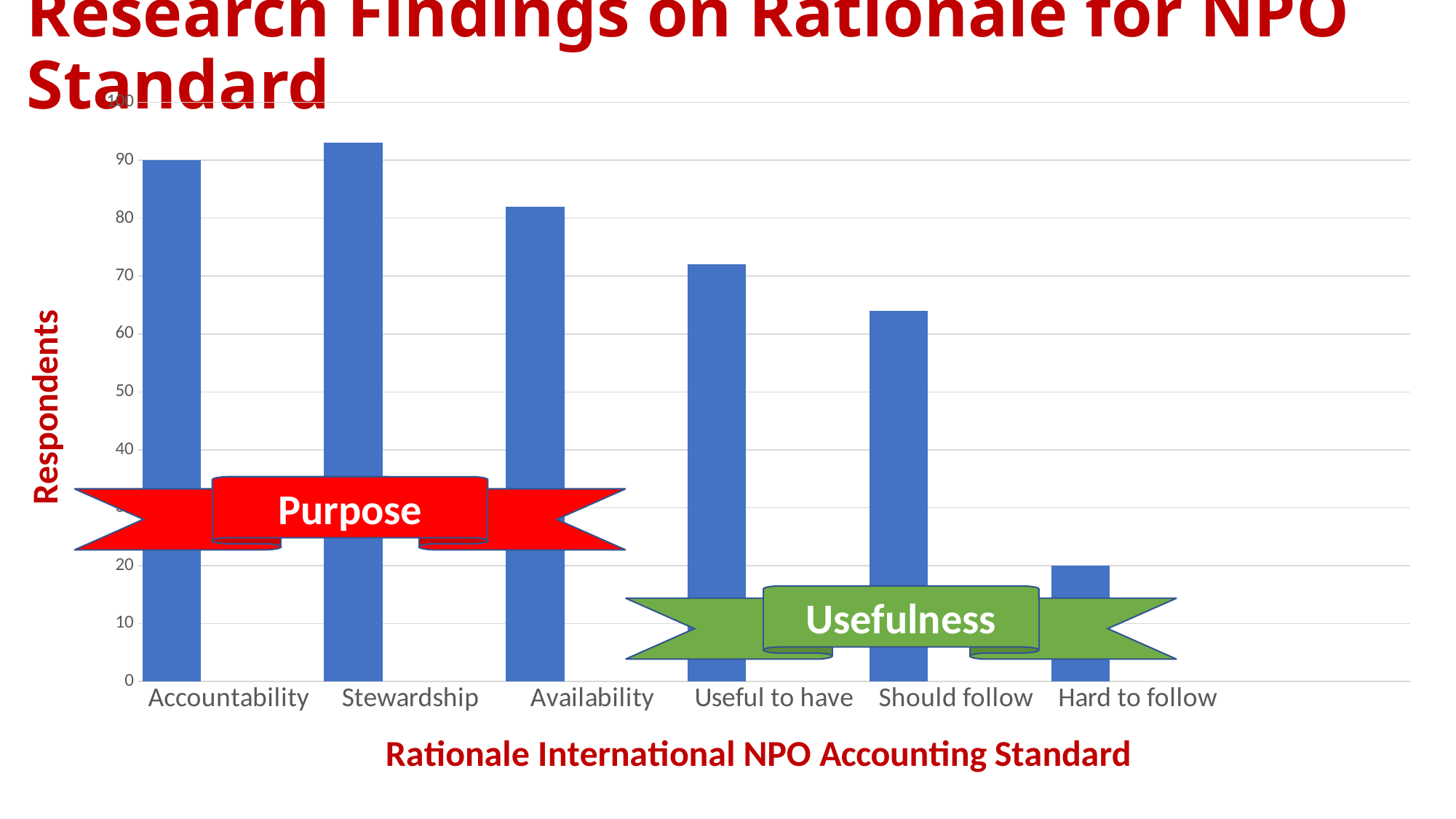
Is the value for Availability greater or less than 80? greater Which category has the lowest number of respondents? Hard to follow Which is larger, the value for Availability or the value for Useful to have? Availability Do the values generally rise or fall from Stewardship to Hard to follow along the x axis? fall How many categories are shown on the x axis of the chart? 6 What is the title of the vertical axis? Respondents What is the value for Accountability? 90 What type of chart is shown on the slide? bar chart Which category has the highest number of respondents? Stewardship What is the value for Hard to follow? 20 Is the value for Stewardship greater or less than 90? greater Is the value for Should follow greater or less than 70? less